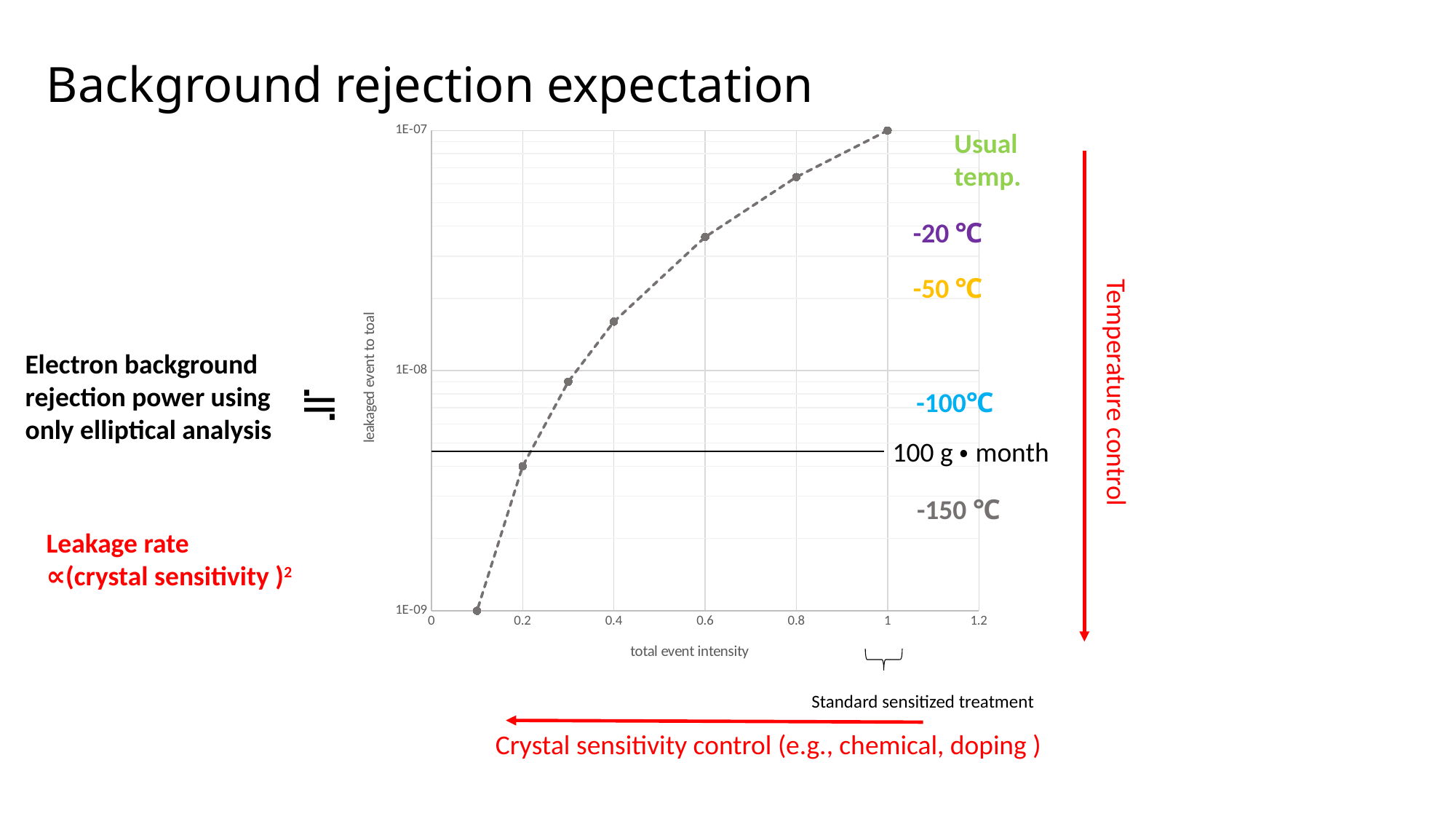
How many data points are plotted on the dashed curve? 7 What is the plotted value at a total event intensity of 1? 1E-07 Which has the larger plotted value: total event intensity 0.6 or 0.3? 0.6 What is the plotted value at a total event intensity of 0.1? 1E-09 What kind of chart is shown on the slide? line chart What is the title of the x axis of the chart? total event intensity Is the value at a total event intensity of 0.2 greater or less than 1E-08? less Is the value at a total event intensity of 0.8 greater or less than 1E-07? less At which total event intensity is the plotted value lowest? 0.1 At which total event intensity is the plotted value highest? 1 Do the plotted values rise or fall as total event intensity increases? rise Is the value at a total event intensity of 0.4 greater or less than 1E-08? greater